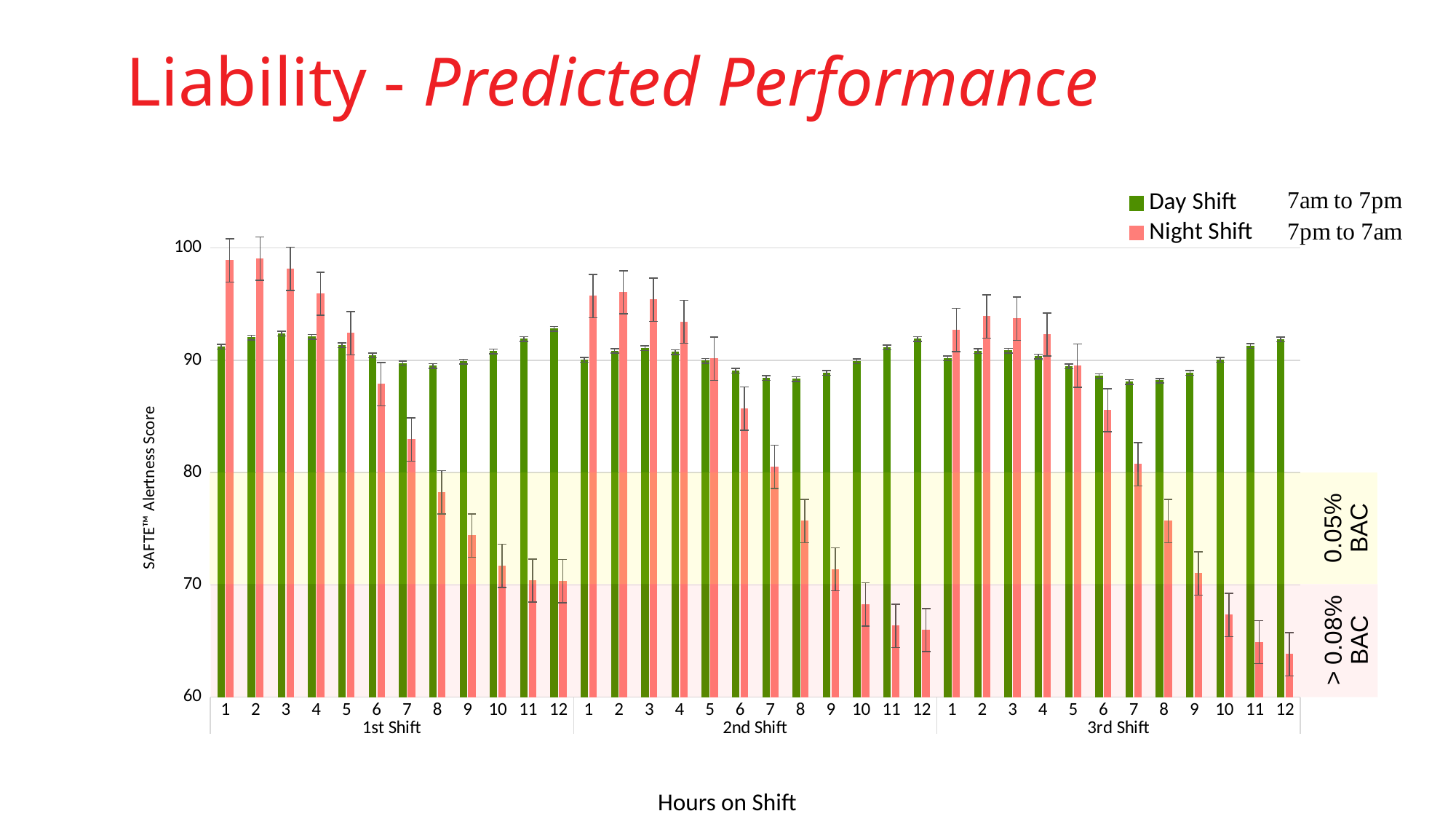
What are the two series named in the legend? Day Shift and Night Shift How many hours are plotted within each shift group on the x axis? 12 At hour 12 of the 1st Shift, which series has the higher value, Day Shift or Night Shift? Day Shift Is the Night Shift value at hour 1 of the 1st Shift greater or less than 90? greater How many shift groups are shown along the x axis? 3 Is the Night Shift value at hour 12 of the 3rd Shift greater or less than 70? less How many series does the legend list? 2 Within the 1st Shift group, do the Night Shift values rise or fall from hour 1 to hour 12? fall What is the label on the vertical axis? SAFTE™ Alertness Score Is the Day Shift value at hour 7 of the 2nd Shift greater or less than 80? greater What kind of chart is shown on the slide? bar chart At hour 1 of the 2nd Shift, which series has the higher value, Day Shift or Night Shift? Night Shift